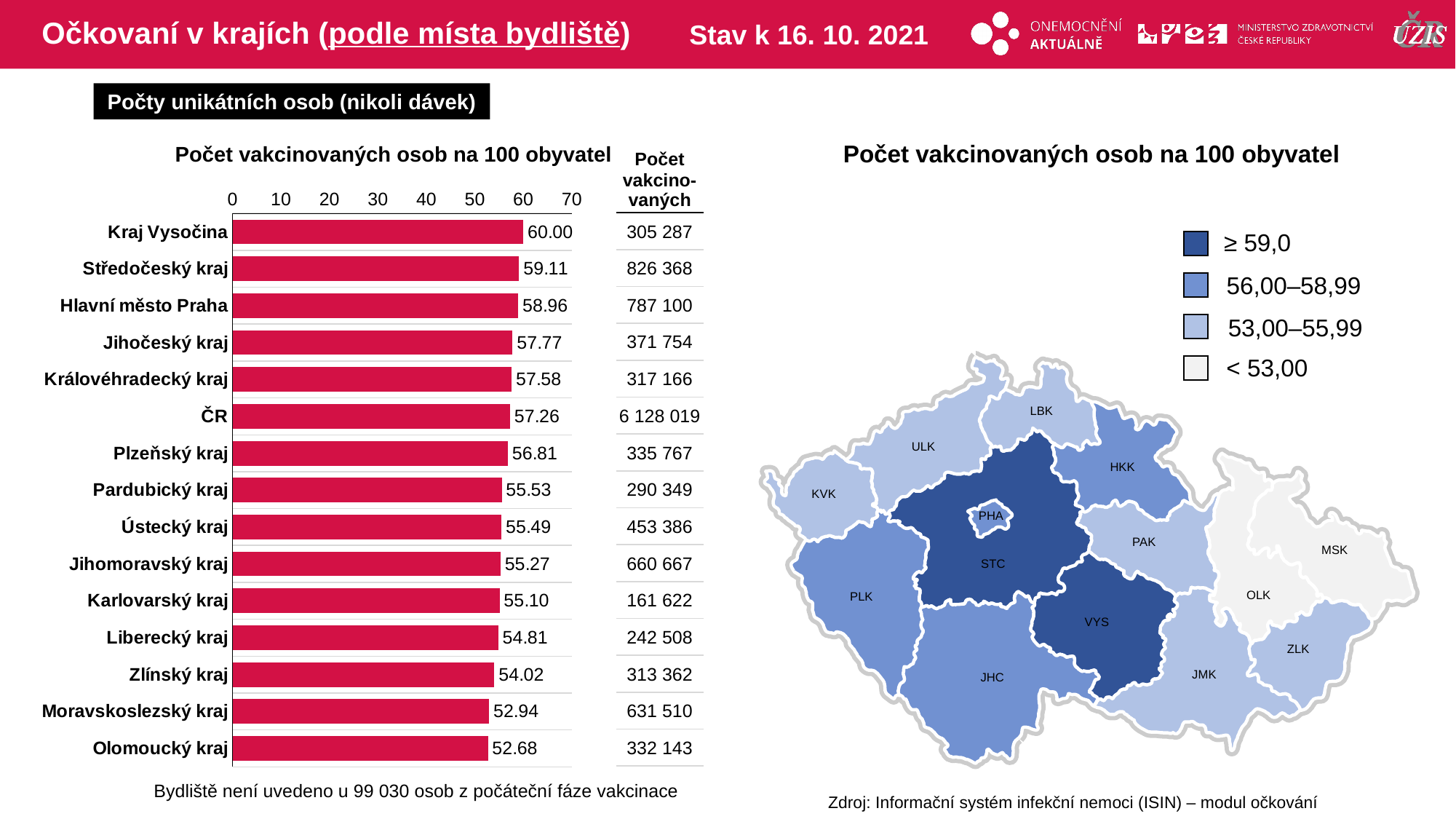
In the bar chart 'Počet vakcinovaných osob na 100 obyvatel', what is the value for ČR? 57.26 How many bars are shown in the bar chart 'Počet vakcinovaných osob na 100 obyvatel'? 15 In the bar chart 'Počet vakcinovaných osob na 100 obyvatel', which region has the lowest value? Olomoucký kraj In the bar chart 'Počet vakcinovaných osob na 100 obyvatel', what is the difference between the values for Středočeský kraj and Hlavní město Praha? 0.15 In the bar chart 'Počet vakcinovaných osob na 100 obyvatel', which region has the highest value? Kraj Vysočina In the bar chart 'Počet vakcinovaných osob na 100 obyvatel', what is the value for Kraj Vysočina? 60.00 In the bar chart 'Počet vakcinovaných osob na 100 obyvatel', which is larger: the value for Jihočeský kraj or the value for Zlínský kraj? Jihočeský kraj What kind of chart is used on the left side of the slide to show 'Počet vakcinovaných osob na 100 obyvatel'? bar chart In the bar chart 'Počet vakcinovaných osob na 100 obyvatel', is the value for Moravskoslezský kraj greater or less than 60? less In the bar chart 'Počet vakcinovaných osob na 100 obyvatel', what is the value for Plzeňský kraj? 56.81 How many categories does the legend of the map 'Počet vakcinovaných osob na 100 obyvatel' list? 4 In the bar chart 'Počet vakcinovaných osob na 100 obyvatel', what is the difference between the values for Kraj Vysočina and Olomoucký kraj? 7.32